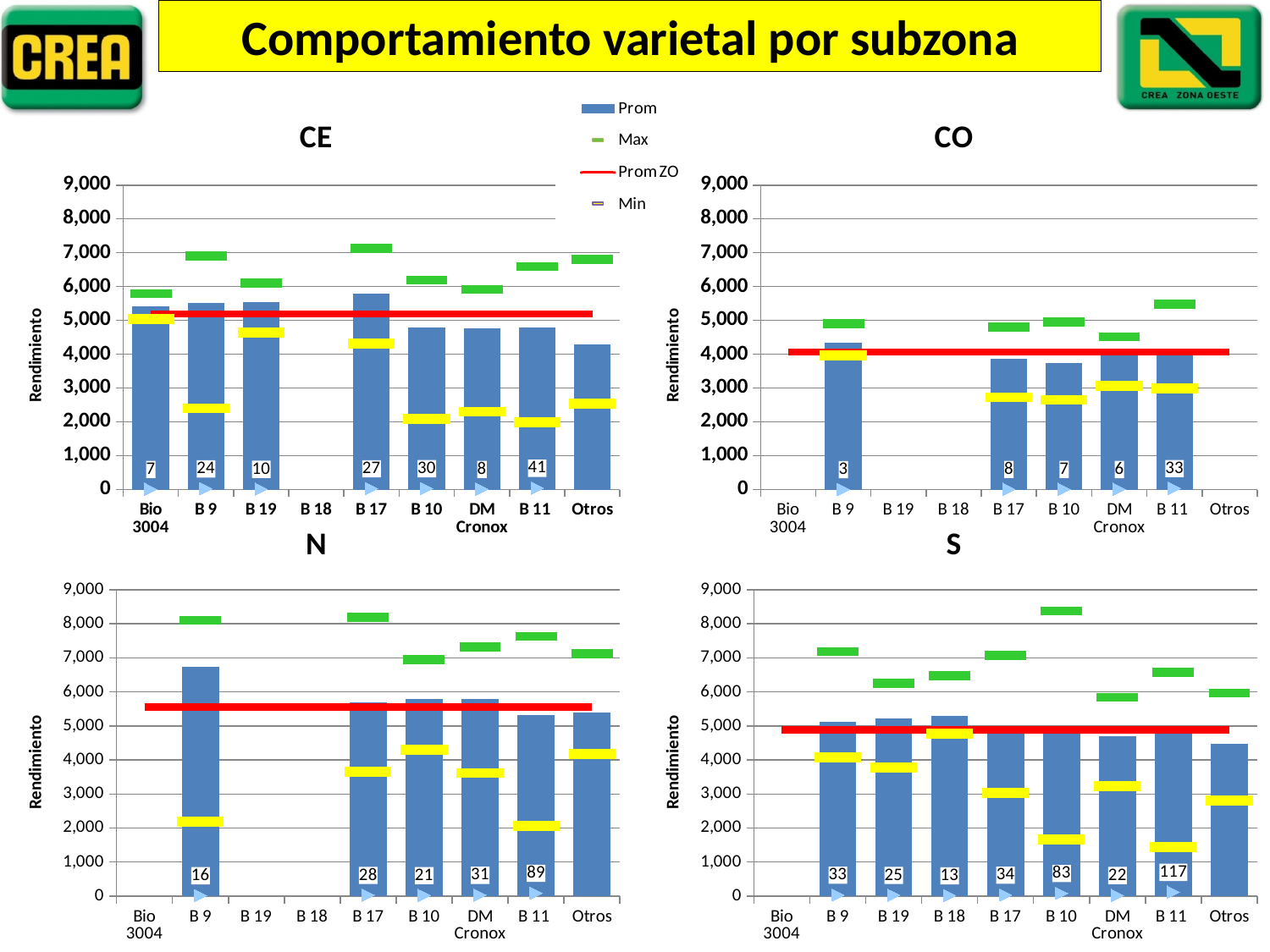
In the CO chart, is the Prom value for B 10 greater or less than 4,000? less What kind of chart is the CE chart? bar chart In the CE chart, which category has the shortest Prom bar? Otros In the CE chart, which category has the tallest Prom bar? B 17 In the N chart, which category has the tallest Prom bar? B 9 How many series does the legend list? 4 In the S chart, what number is printed inside the B 11 bar? 117 In the CE chart, what number is printed inside the B 11 bar? 41 In the CO chart, which category has the tallest Prom bar? B 9 How many categories are shown on the x axis of the CE chart? 9 In the CE chart, is the Prom value for B 17 greater or less than 5,000? greater In the N chart, is the Prom value for B 9 greater or less than 6,000? greater